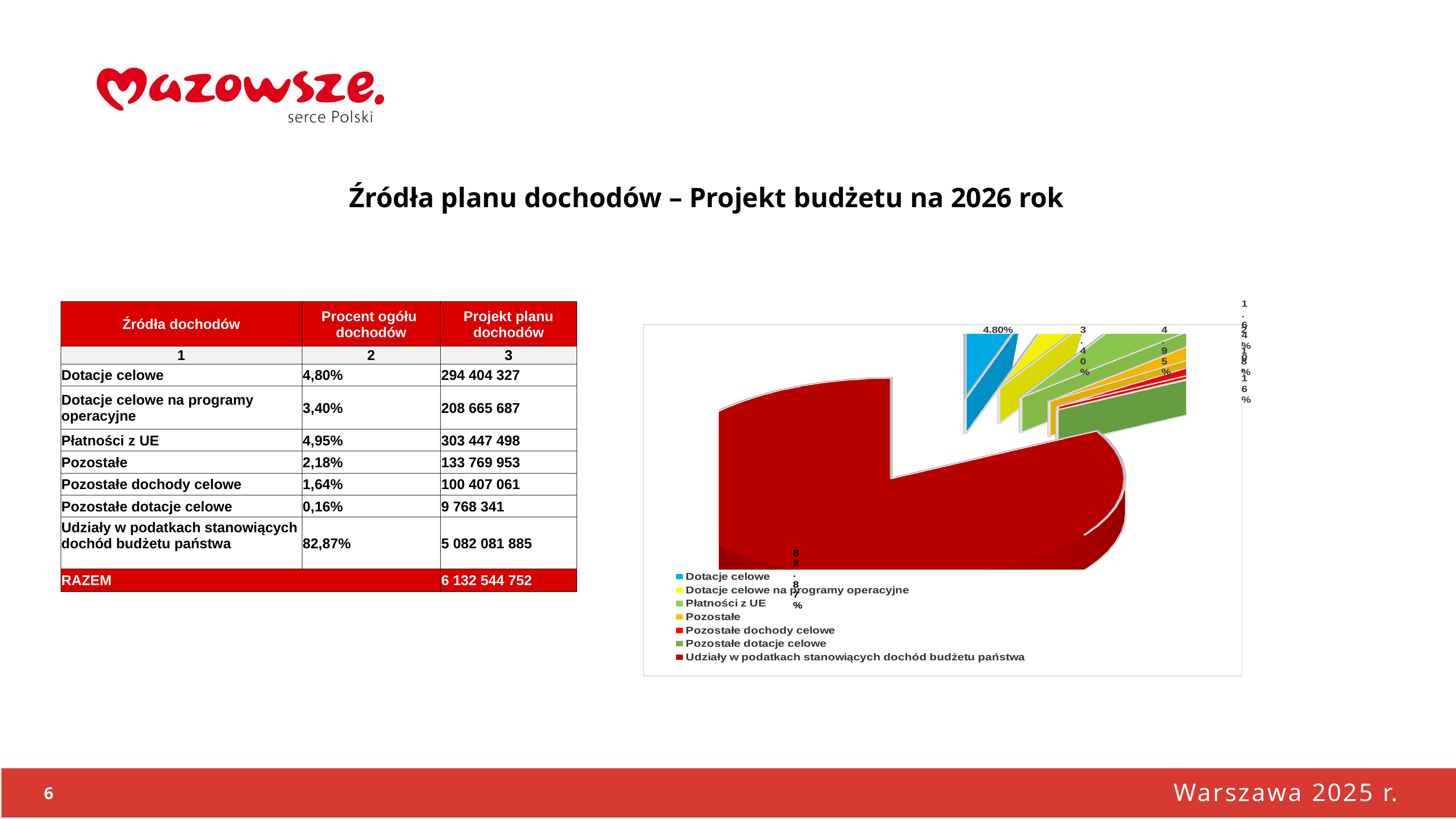
What share of the pie chart is labelled for Płatności z UE? 4.95% How many entries does the legend of the pie chart list? 7 In the pie chart, which slice is larger: Dotacje celowe or Dotacje celowe na programy operacyjne? Dotacje celowe How many slices does the pie chart have? 7 What share of the pie chart is labelled for Udziały w podatkach stanowiących dochód budżetu państwa? 82.87% Which category has the largest slice in the pie chart? Udziały w podatkach stanowiących dochód budżetu państwa What colour does the legend assign to Dotacje celowe in the pie chart? blue In the pie chart, what is the difference in percentage points between the Udziały w podatkach stanowiących dochód budżetu państwa slice and the Dotacje celowe slice? 78.07% What kind of chart is shown on the right of the slide? pie chart What share of the pie chart is labelled for Dotacje celowe? 4.80% What colour is the Udziały w podatkach stanowiących dochód budżetu państwa slice in the pie chart? dark red